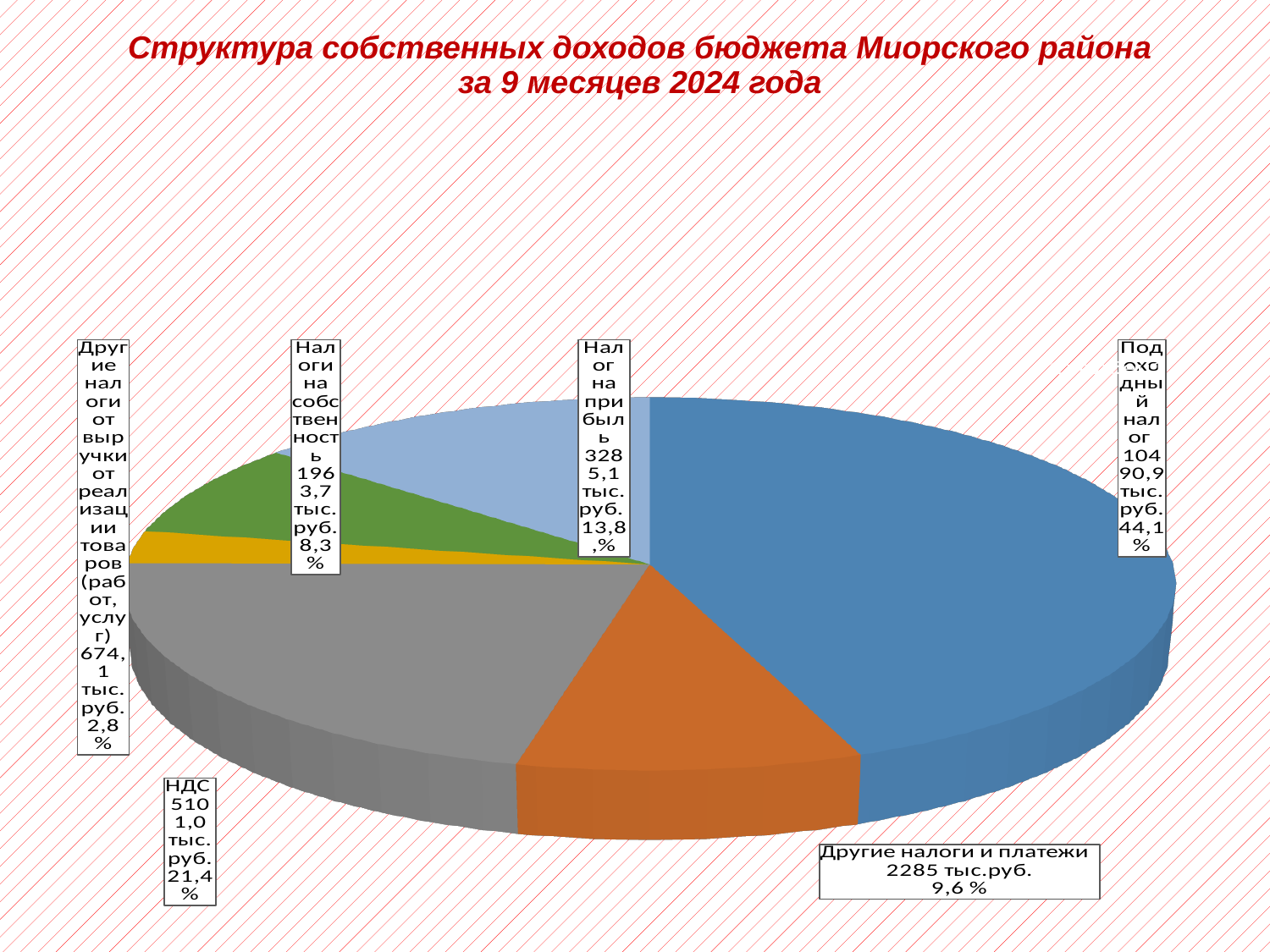
Which is larger, the share for НДС or the share for Налог на прибыль? НДС What is the difference in percentage points between the share for Подоходный налог and the share for НДС? 22,7 What kind of chart is shown on the slide? pie chart What share of the pie does Подоходный налог account for? 44,1 % Which slice of the pie is the smallest? Другие налоги от выручки от реализации товаров (работ, услуг) Which slice of the pie is the largest? Подоходный налог What is the value shown for Налоги на собственность? 1963,7 тыс.руб. What is the value shown for Другие налоги и платежи? 2285 тыс.руб. What share of the pie does Налог на прибыль account for? 13,8 % What is the value shown for НДС? 5101,0 тыс.руб. How many slices does the pie chart have? 6 What is the title of the chart? Структура собственных доходов бюджета Миорского района за 9 месяцев 2024 года